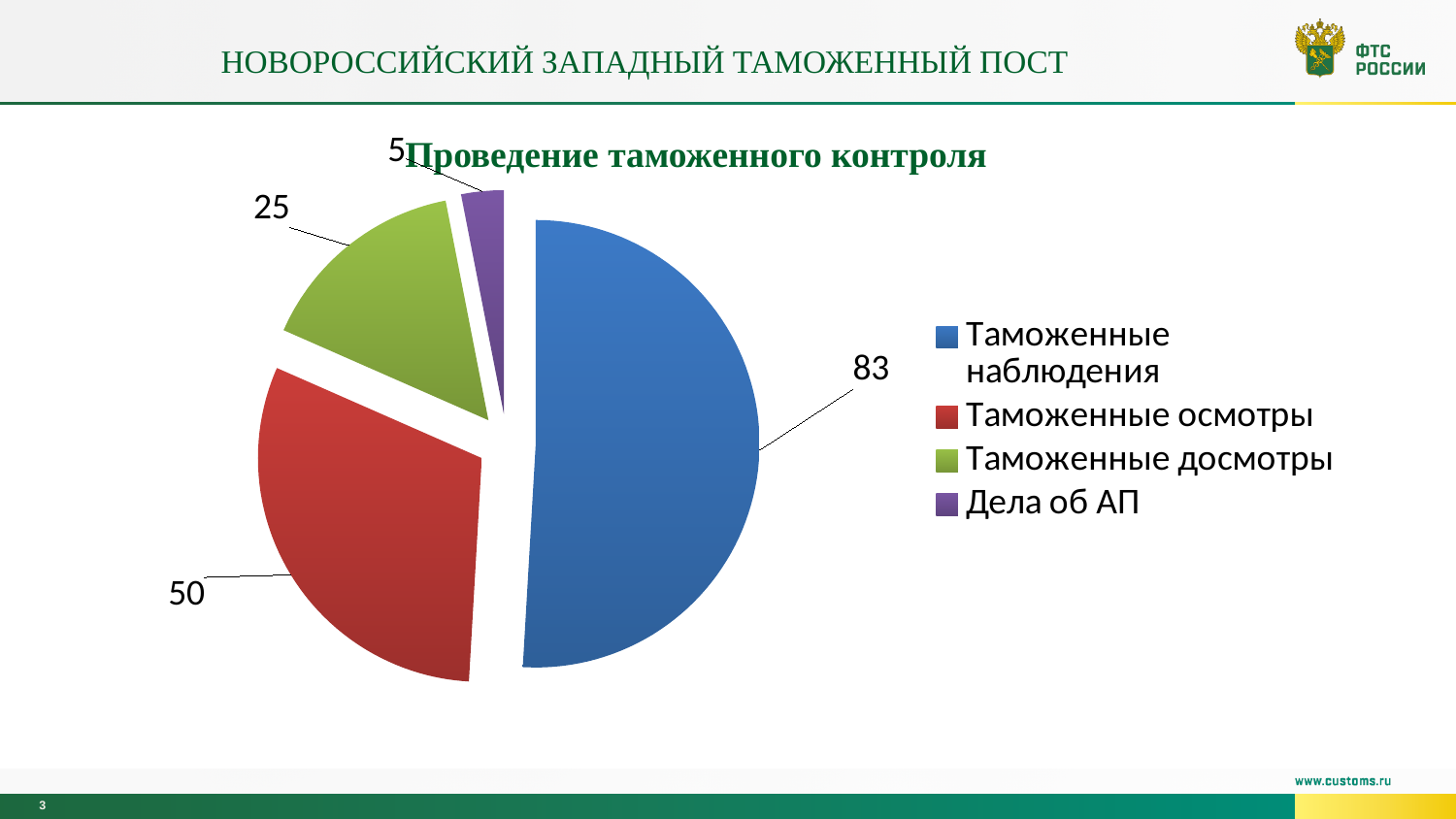
What is the value for Таможенные наблюдения? 83 What is the value for Дела об АП? 5 What colour is the slice for Таможенные досмотры? Green How many categories does the pie chart have? 4 What is the difference between the values for Таможенные наблюдения and Таможенные осмотры? 33 What is the value for Таможенные досмотры? 25 What is the title of the chart? Проведение таможенного контроля Which is larger, the value for Таможенные осмотры or the value for Таможенные досмотры? Таможенные осмотры What type of chart is shown on the slide? Pie chart Which category has the largest slice of the pie? Таможенные наблюдения Which category has the smallest slice of the pie? Дела об АП What is the value for Таможенные осмотры? 50